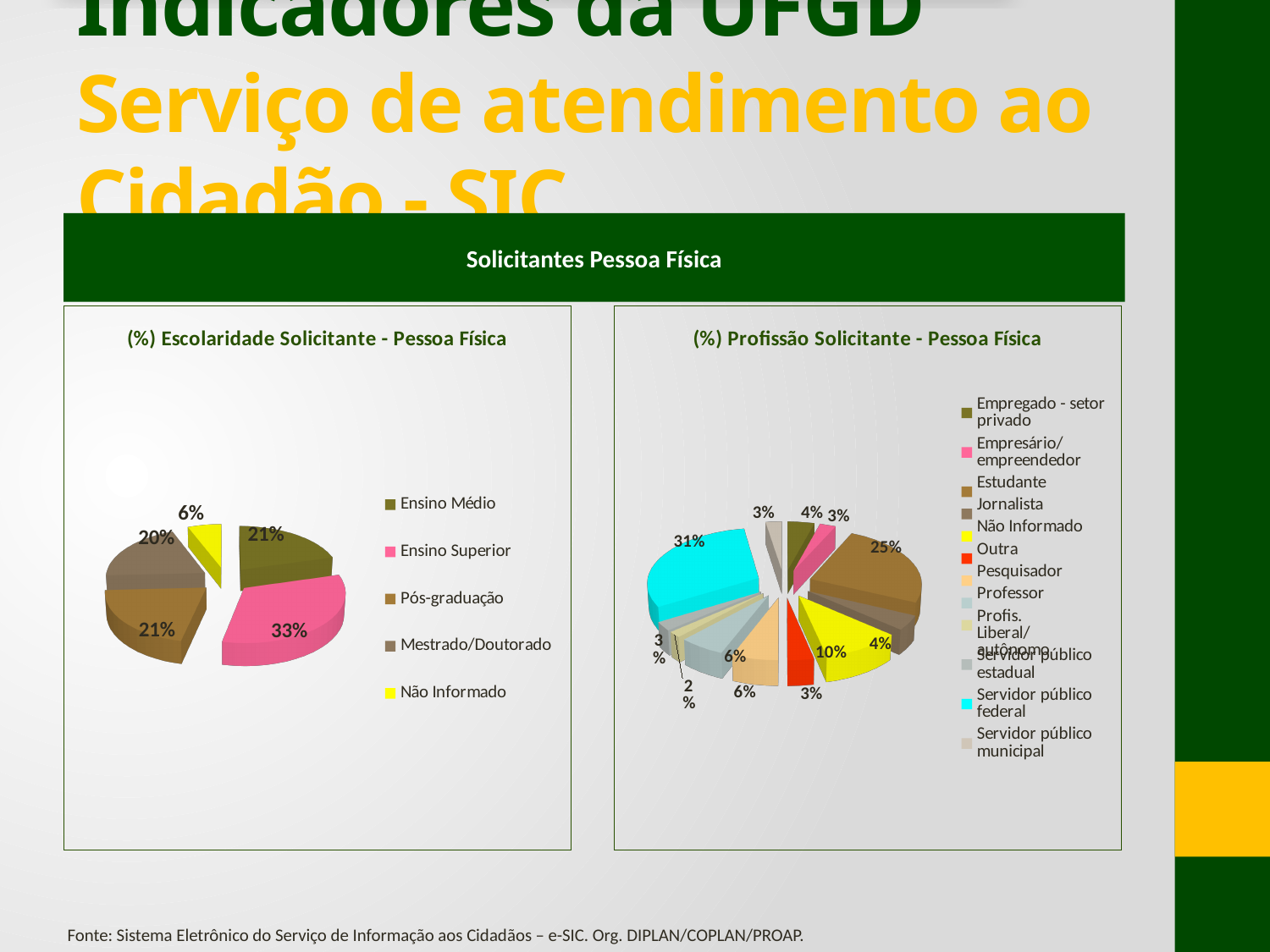
In the '(%) Escolaridade Solicitante - Pessoa Física' chart, which category has the smallest share? Não Informado How many categories does the '(%) Escolaridade Solicitante - Pessoa Física' chart show? 5 In the '(%) Escolaridade Solicitante - Pessoa Física' chart, which category has the largest share? Ensino Superior In the '(%) Profissão Solicitante - Pessoa Física' chart, which is larger: Estudante or Não Informado? Estudante What kind of chart is the '(%) Escolaridade Solicitante - Pessoa Física' chart? Pie chart In the '(%) Profissão Solicitante - Pessoa Física' chart, which category has the largest share? Servidor público federal In the '(%) Profissão Solicitante - Pessoa Física' chart, what is the value for Não Informado? 10% In the '(%) Profissão Solicitante - Pessoa Física' chart, what is the value for Estudante? 25% In the '(%) Escolaridade Solicitante - Pessoa Física' chart, what is the difference between Ensino Superior and Não Informado? 27 percentage points In the '(%) Escolaridade Solicitante - Pessoa Física' chart, what is the value for Ensino Superior? 33% How many entries does the legend of the '(%) Profissão Solicitante - Pessoa Física' chart list? 12 In the '(%) Profissão Solicitante - Pessoa Física' chart, what is the value for Servidor público federal? 31%